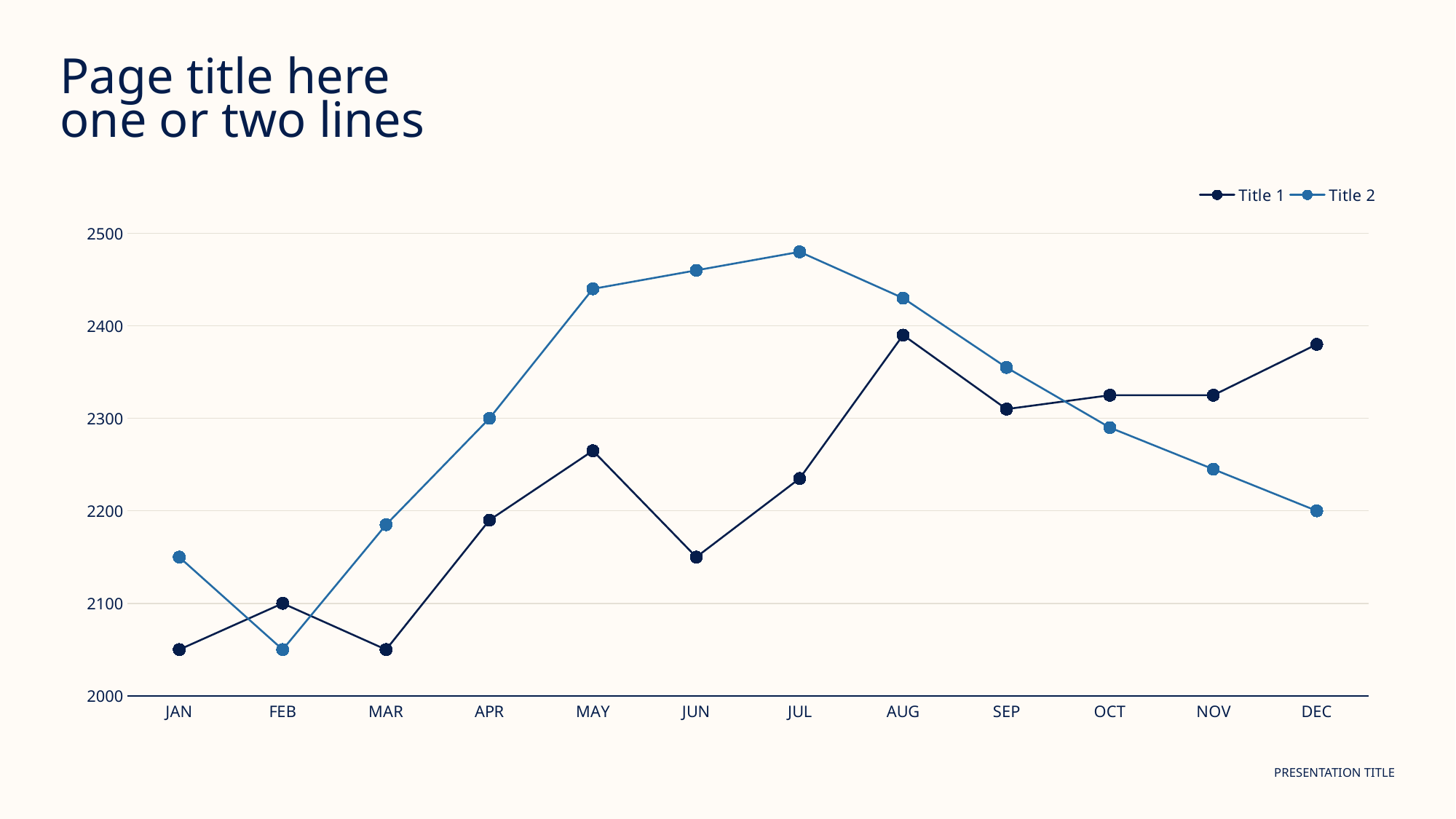
In which month does Title 2 reach its highest value? JUL In JUL, which series has the larger value, Title 1 or Title 2? Title 2 Is the value for Title 2 in JUL greater or less than 2400? greater What is the value of Title 1 in FEB? 2100 What kind of chart is shown on the slide? line chart What is the value of Title 2 in DEC? 2200 Does Title 2 rise or fall from JUL to DEC? fall In which month does Title 2 have its lowest value? FEB Is the value for Title 1 in JUN greater or less than 2200? less How many series does the legend list? 2 What is the value of Title 2 in APR? 2300 How many months are plotted along the x axis? 12